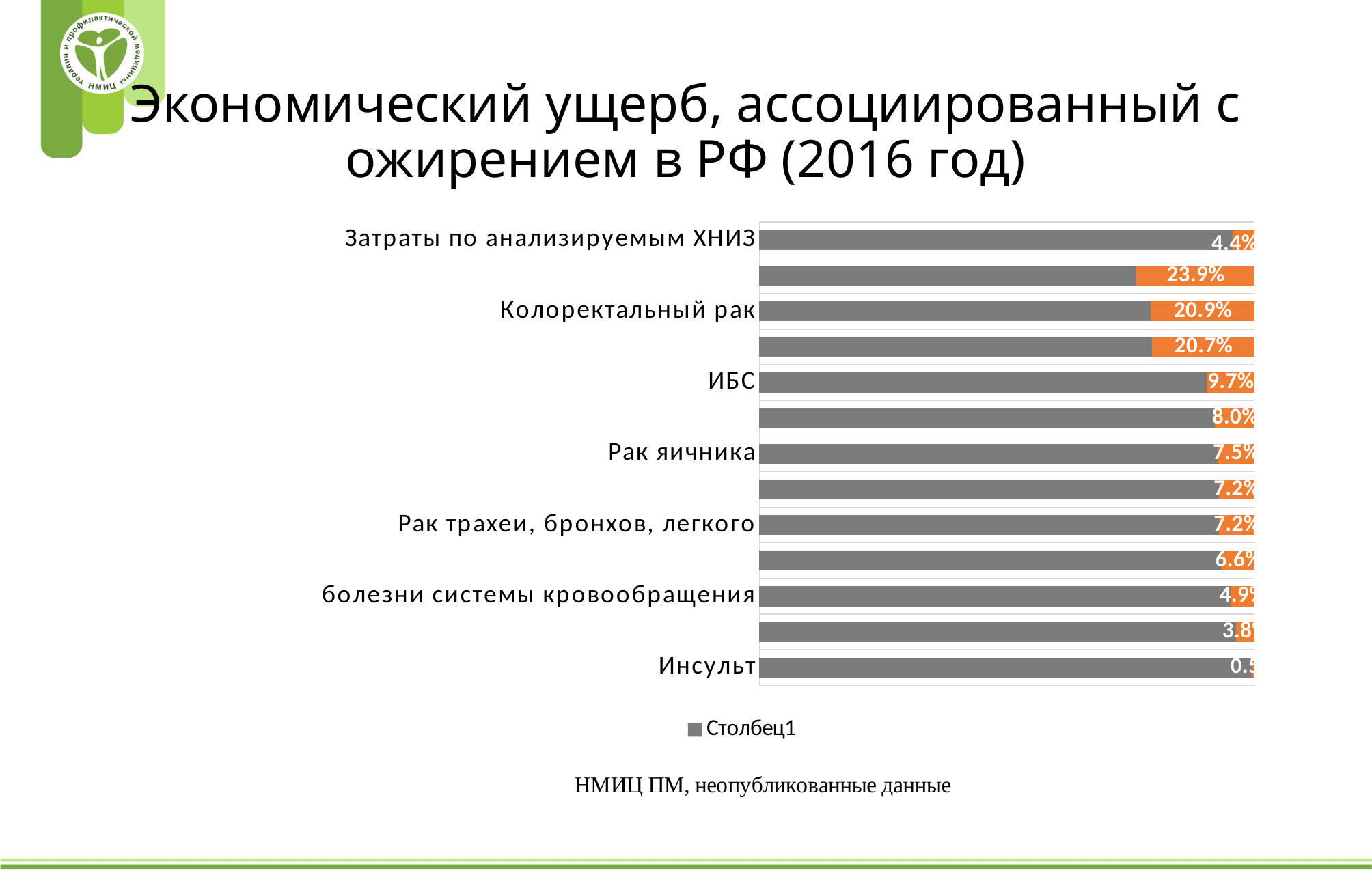
What is the difference between the values for Колоректальный рак and ИБС? 11.2% What value is shown for ИБС? 9.7% What value is shown for Затраты по анализируемым ХНИЗ? 4.4% How many series does the legend list? 1 What value is shown for Колоректальный рак? 20.9% Which is larger, the value for ИБС or the value for Рак яичника? ИБС How many bars are plotted in the chart? 13 What value is shown for Рак трахеи, бронхов, легкого? 7.2% What value is shown for Рак яичника? 7.5% What kind of chart is shown on the slide? Bar chart Which category has the lowest value in the chart? Инсульт What value is shown for болезни системы кровообращения? 4.9%